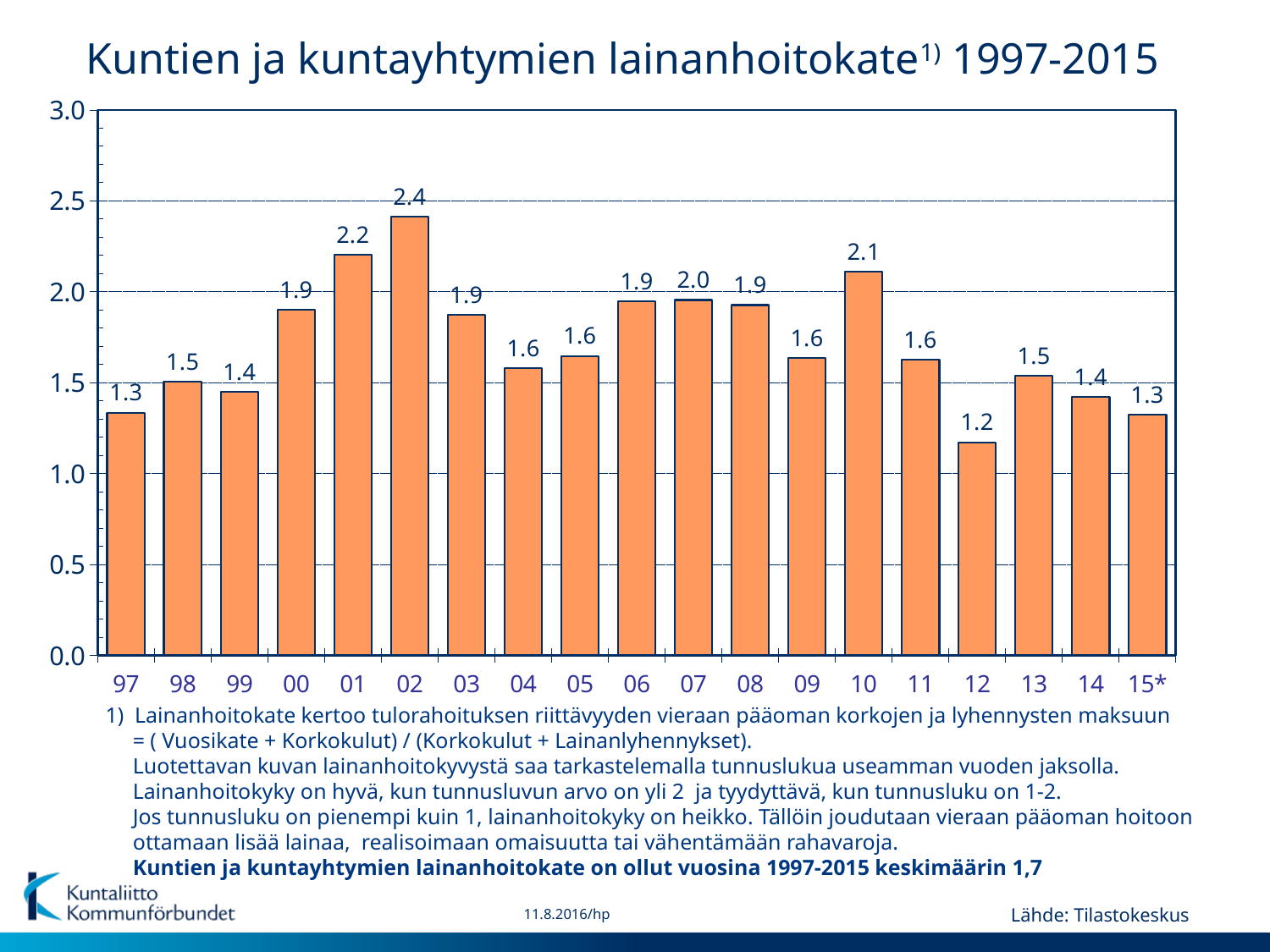
Do the values rise or fall from 10 to 12? fall Which is larger, the value for 01 or the value for 07? 01 Is the value for 10 greater or less than 2.0? greater Which year has the lowest value? 12 What kind of chart is shown on the slide? bar chart What is the value for 10? 2.1 What is the value for 02? 2.4 How many bars are shown in the chart? 19 What is the value for 15*? 1.3 Which year has the highest value? 02 What is the value for 12? 1.2 What is the difference between the values for 02 and 12? 1.2